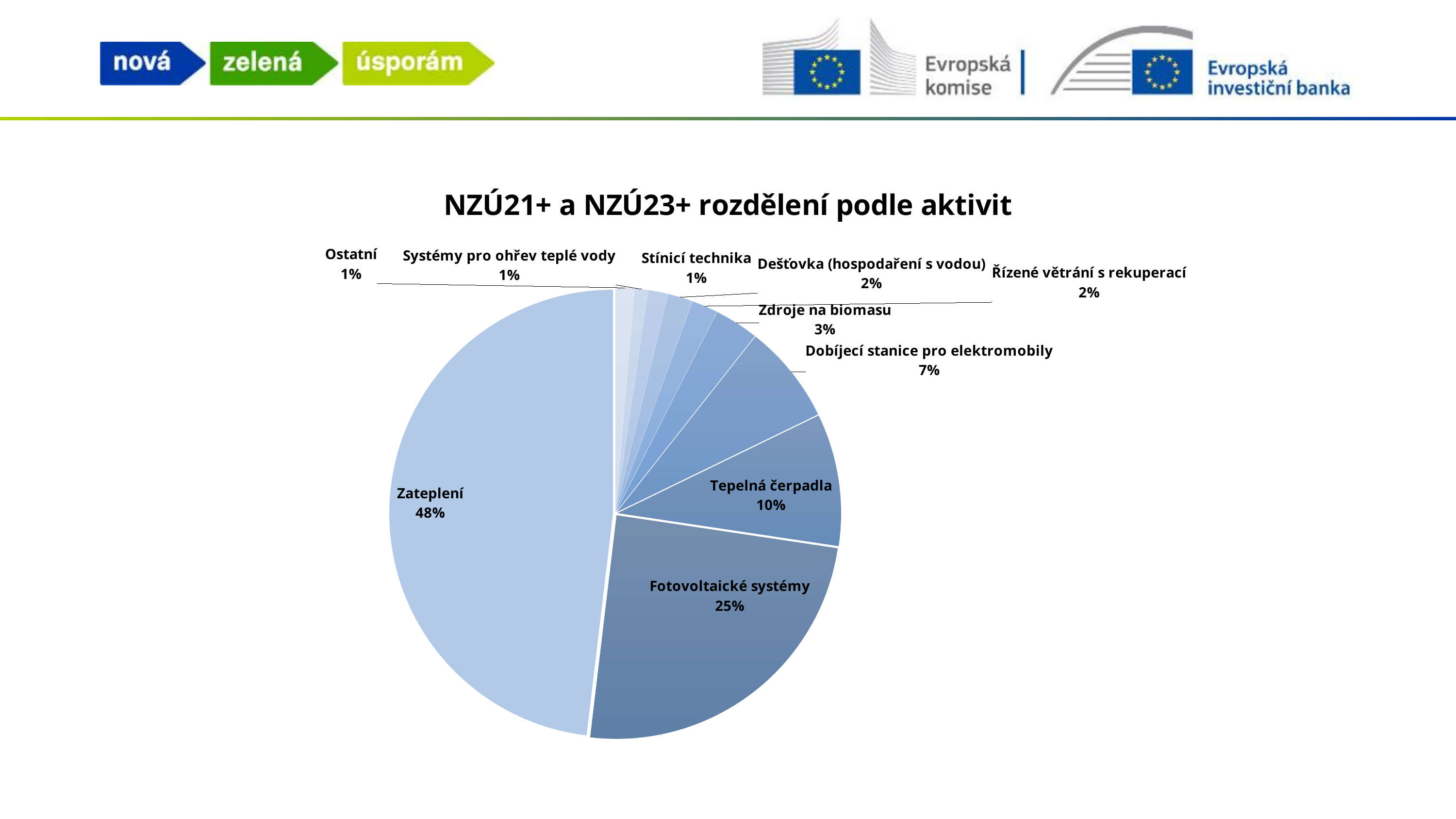
How many categories (slices) does the pie chart have? 10 What is the title of the chart? NZÚ21+ a NZÚ23+ rozdělení podle aktivit What kind of chart is shown on the slide? pie chart Which category has the largest slice of the pie? Zateplení What is the value for Dobíjecí stanice pro elektromobily? 7% What is the value for Zdroje na biomasu? 3% What share of the pie does Zateplení have? 48% What is the value for Tepelná čerpadla? 10% What is the combined share of Tepelná čerpadla and Fotovoltaické systémy? 35% Which is larger, the share for Tepelná čerpadla or the share for Dobíjecí stanice pro elektromobily? Tepelná čerpadla What is the difference between the shares of Zateplení and Fotovoltaické systémy? 23% What share of the pie does Fotovoltaické systémy have? 25%